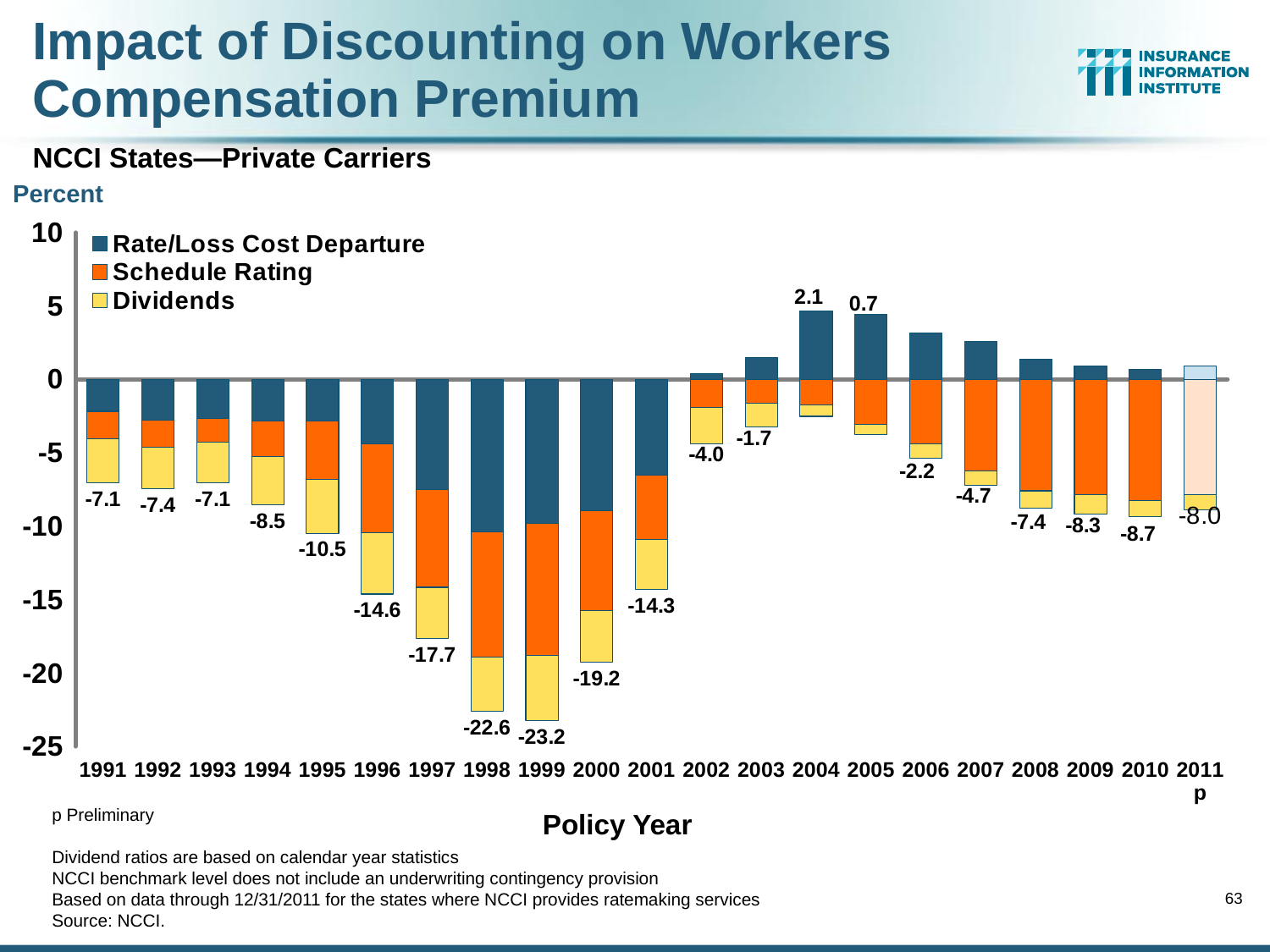
How many policy years are shown on the x axis? 21 Which policy year has a higher labeled net value, 2002 or 2003? 2003 What is the labeled net value for policy year 2004? 2.1 What is the difference between the labeled net values for 1998 and 1999? 0.6 What is the title of the x axis? Policy Year What kind of chart is shown on the slide? Stacked bar chart Which policy year has the highest labeled net value? 2004 What is the labeled net value for policy year 1996? -14.6 What is the labeled net value for policy year 1999? -23.2 What is the labeled net value for policy year 2011p? -8.0 Which policy year has the lowest (most negative) labeled net value? 1999 How many series does the legend list? 3